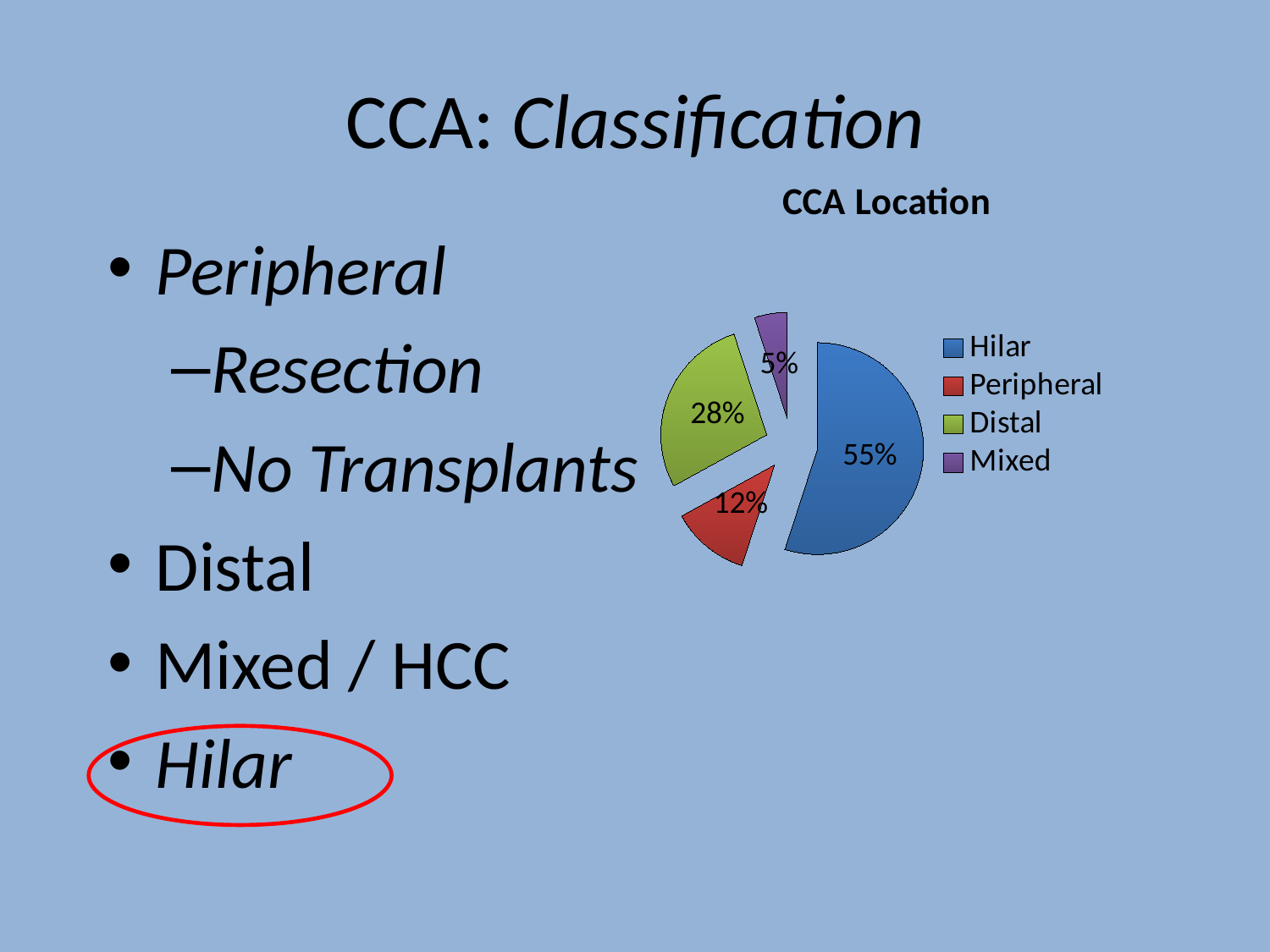
What is the difference in percentage points between Hilar and Distal? 27 What type of chart is shown on the slide? pie chart How many categories does the pie chart show? 4 What is the title of the pie chart? CCA Location What percentage of the pie chart is Distal? 28% What colour is the Hilar slice in the pie chart? blue Which is larger, the Peripheral slice or the Distal slice? Distal Which category has the largest share of the pie chart? Hilar Which category has the smallest share of the pie chart? Mixed What percentage of the pie chart is Peripheral? 12% What percentage of the pie chart is Hilar? 55% What percentage of the pie chart is Mixed? 5%